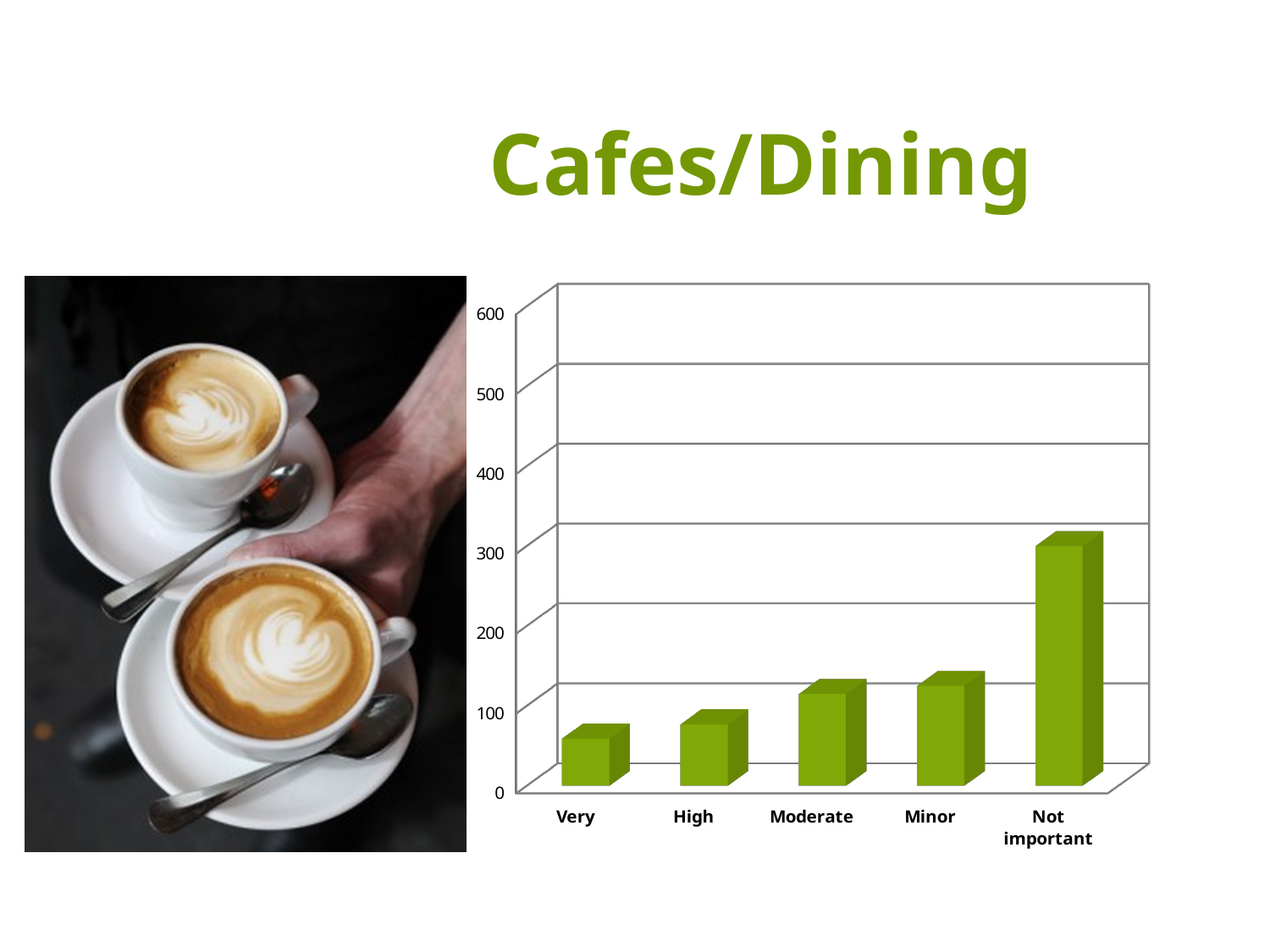
Do the bar values generally rise or fall from Very to Not important along the x axis? rise What kind of chart is shown on the slide? bar chart Is the value for Minor greater or less than 200? less Which is larger, the value for Very or the value for Not important? Not important How many categories are shown on the x axis of the chart? 5 Is the value for Very greater or less than 100? less Is the value for Not important greater or less than 400? less Which category has the highest bar in the chart? Not important What is the title of the slide containing the chart? Cafes/Dining Which category has the lowest bar in the chart? Very